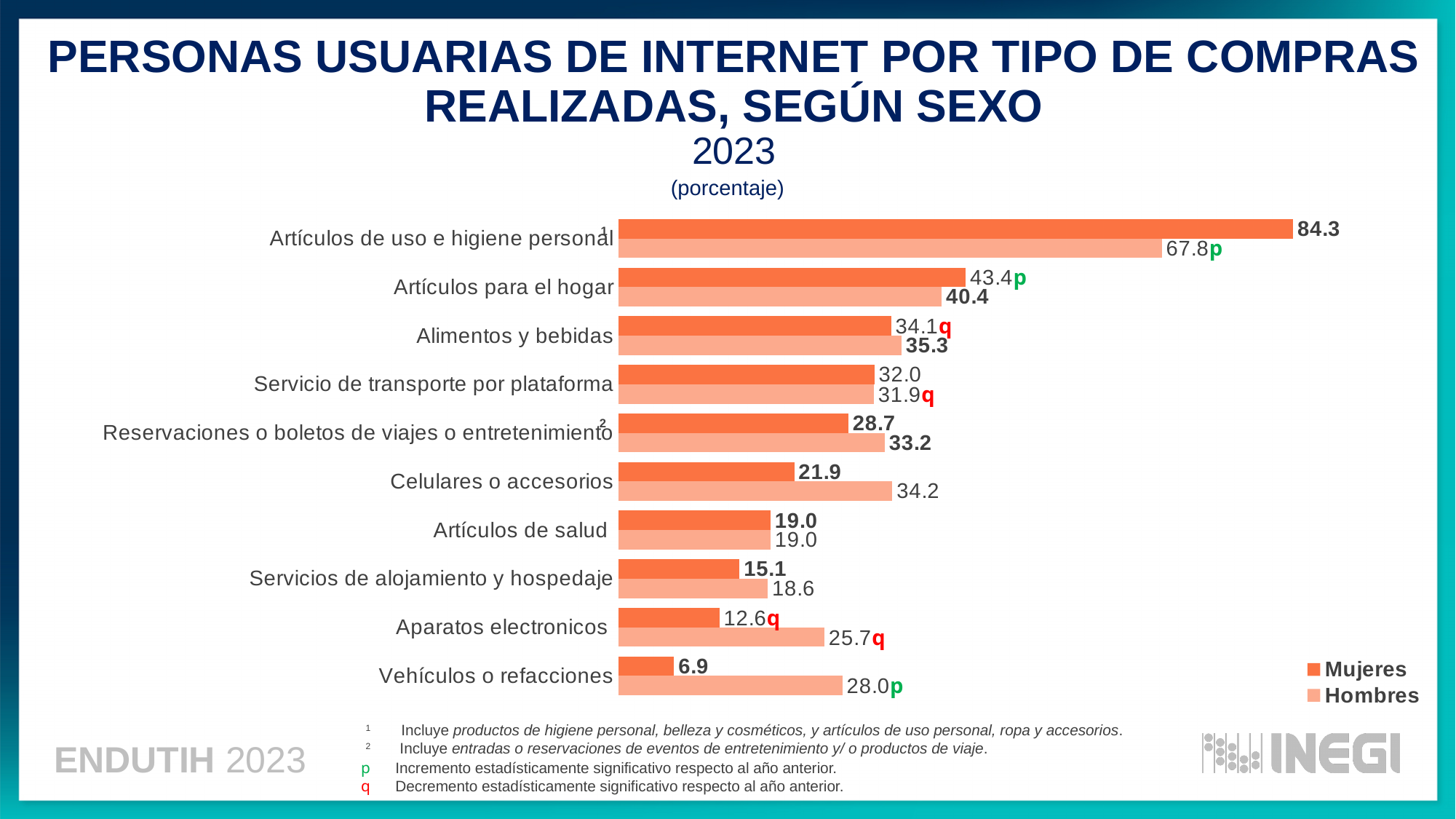
Which series is shown in the darker orange colour in the legend? Mujeres How many purchase categories are shown in the chart? 10 What is the value for Hombres in the category Vehículos o refacciones? 28.0 Which category has the highest value for Hombres? Artículos de uso e higiene personal How many series does the legend list? 2 What is the difference between the Mujeres and Hombres values for Aparatos electronicos? 13.1 Which category has the lowest value for Mujeres? Vehículos o refacciones Which is larger for Reservaciones o boletos de viajes o entretenimiento, the Mujeres value or the Hombres value? Hombres What is the value for Hombres in the category Celulares o accesorios? 34.2 What is the value for Mujeres in the category Artículos de uso e higiene personal? 84.3 What type of chart is shown on the slide? bar chart What is the difference between the Mujeres and Hombres values for Artículos de uso e higiene personal? 16.5